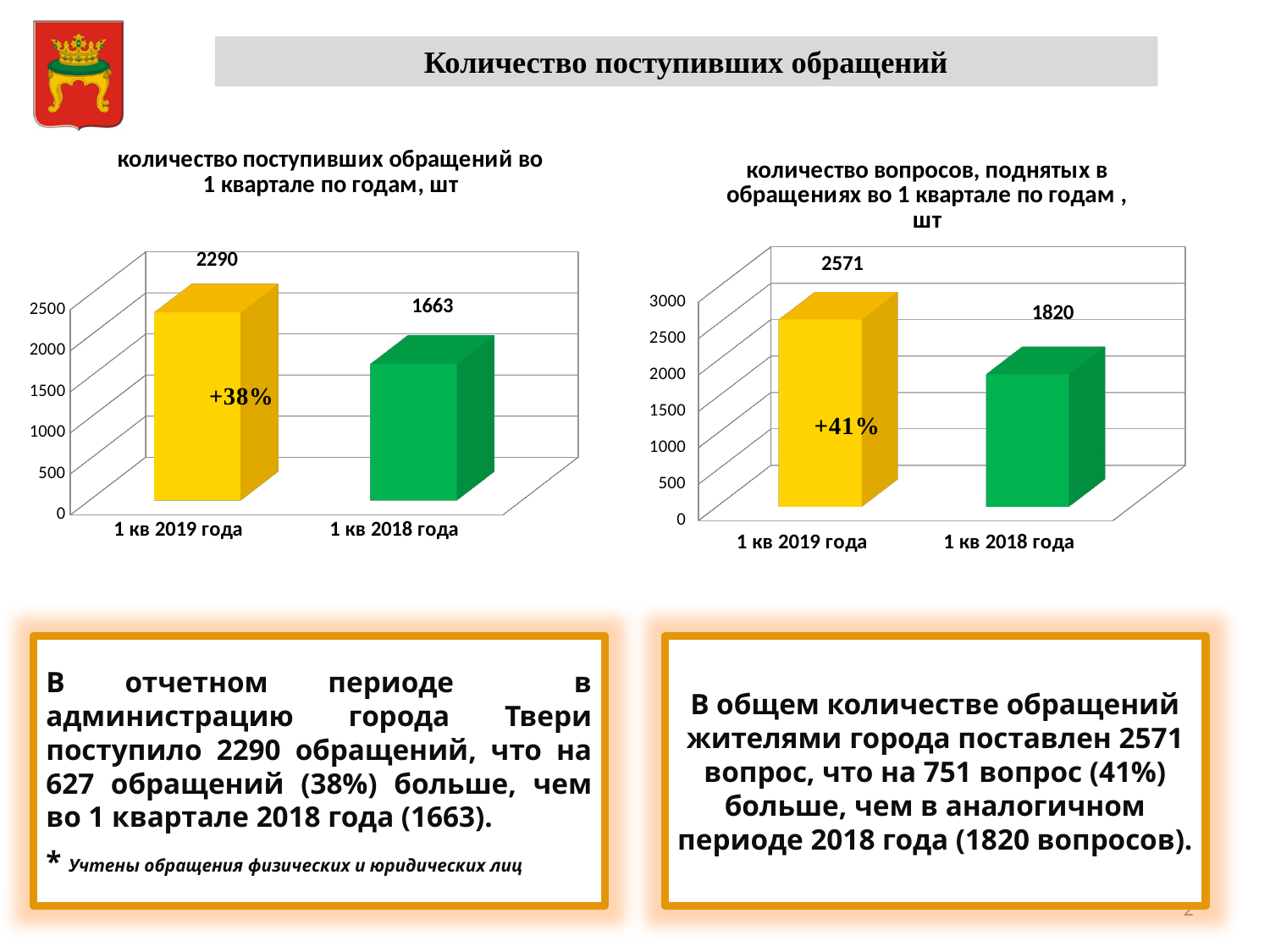
In the right chart (количество вопросов, поднятых в обращениях во 1 квартале по годам, шт), what is the value for 1 кв 2019 года? 2571 In the left chart, which category has the highest value? 1 кв 2019 года In the right chart (количество вопросов, поднятых в обращениях во 1 квартале по годам, шт), what is the value for 1 кв 2018 года? 1820 In the left chart (количество поступивших обращений во 1 квартале по годам, шт), what is the value for 1 кв 2018 года? 1663 How many categories are shown in the left chart? 2 In the left chart (количество поступивших обращений во 1 квартале по годам, шт), what is the value for 1 кв 2019 года? 2290 In the right chart, which is larger: the value for 1 кв 2019 года or 1 кв 2018 года? 1 кв 2019 года In the left chart, what percentage change label is printed on the 1 кв 2019 года bar? +38% In the right chart, which category has the lowest value? 1 кв 2018 года What kind of chart is the right chart? bar chart In the right chart, what is the difference between the values for 1 кв 2019 года and 1 кв 2018 года? 751 In the left chart, what is the difference between the values for 1 кв 2019 года and 1 кв 2018 года? 627